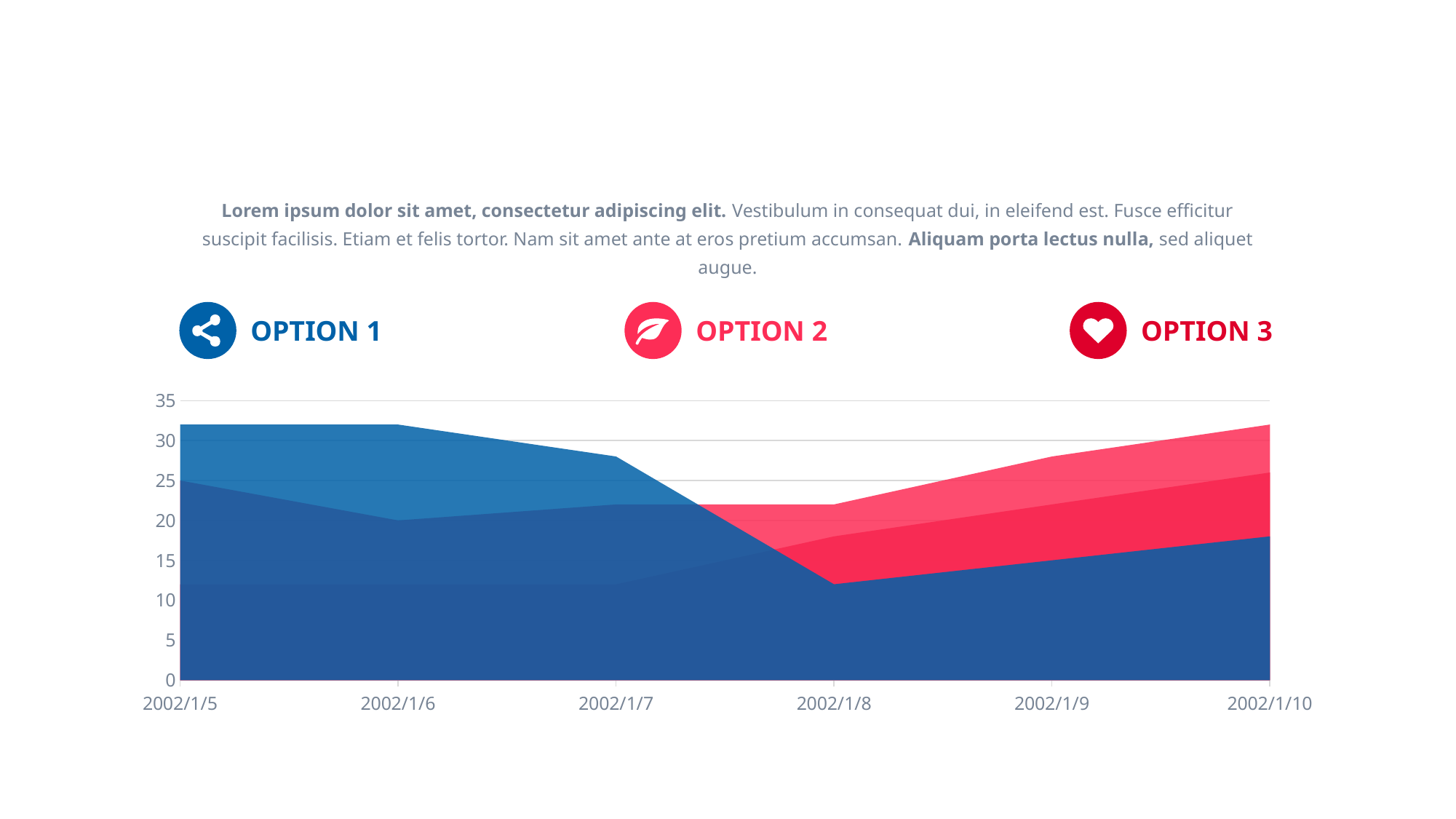
What is the first date shown on the x axis of the chart? 2002/1/5 What is the last date shown on the x axis of the chart? 2002/1/10 Is the top of the plotted area at 2002/1/5 greater or less than 30? greater At which date does the top of the plotted area reach its lowest point? 2002/1/8 Does the top of the plotted area rise or fall from 2002/1/5 to 2002/1/8? fall What is the highest value shown on the y axis of the chart? 35 Does the top of the plotted area rise or fall from 2002/1/8 to 2002/1/10? rise Is the top of the plotted area at 2002/1/8 greater or less than 25? less What kind of chart is shown on the slide? Area chart Is the top of the plotted area at 2002/1/10 greater or less than 30? greater How many option labels are shown above the chart? 3 How many dates are shown along the x axis of the chart? 6